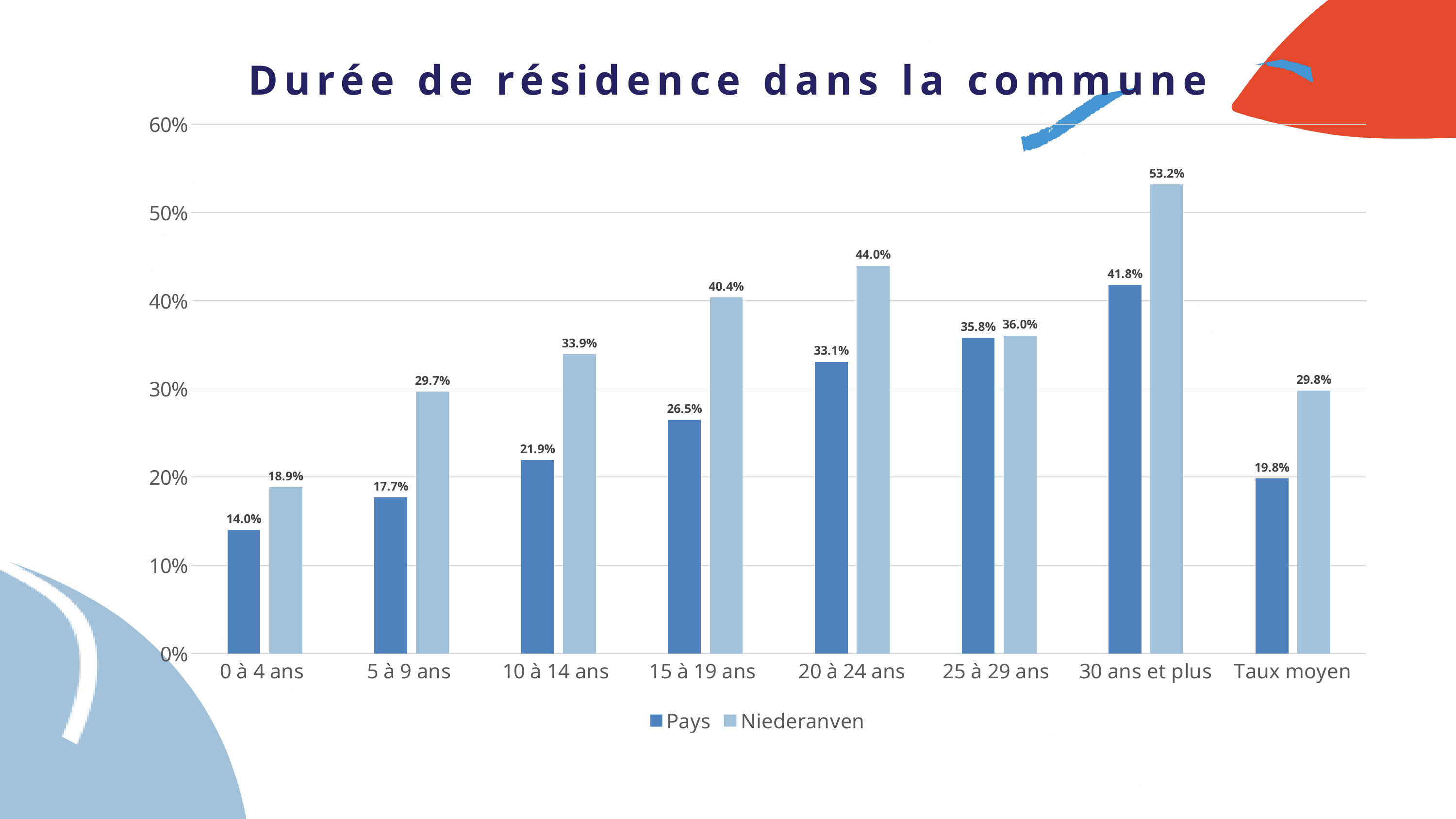
What is the title of the chart? Durée de résidence dans la commune Which category has the lowest Niederanven value? 0 à 4 ans What is the Niederanven value for 30 ans et plus? 53.2% What is the Niederanven value for Taux moyen? 29.8% Do the Pays values rise or fall from 0 à 4 ans to 30 ans et plus? Rise How many series does the legend list? 2 Which is larger for 10 à 14 ans, the Pays value or the Niederanven value? Niederanven What kind of chart is shown on the slide? Bar chart What is the Pays value for 15 à 19 ans? 26.5% What is the difference between the Niederanven and Pays values for 20 à 24 ans? 10.9% How many categories are shown on the x axis? 8 Which category has the highest Pays value? 30 ans et plus